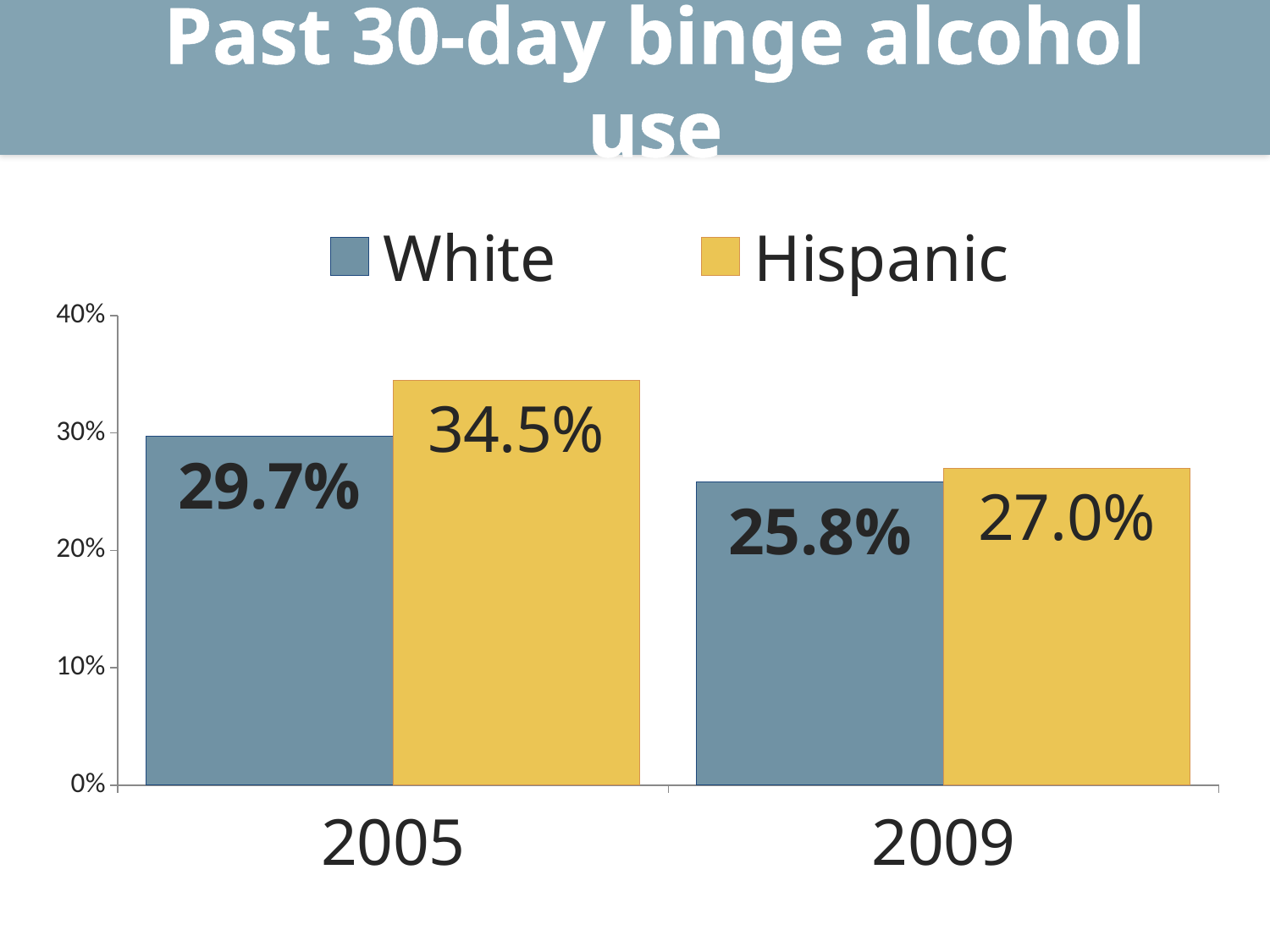
What is the value for White in 2009? 25.8% What is the difference between the Hispanic and White values in 2005? 4.8% What is the difference between the Hispanic value in 2005 and the Hispanic value in 2009? 7.5% Do the White values rise or fall from 2005 to 2009? Fall Which bar has the lowest value on the chart? White in 2009 What kind of chart is shown? Bar chart What is the value for Hispanic in 2005? 34.5% How many series does the legend list? 2 What is the value for Hispanic in 2009? 27.0% What is the value for White in 2005? 29.7% Which is larger, the White value in 2005 or the White value in 2009? White in 2005 Which group has the highest value in 2005? Hispanic